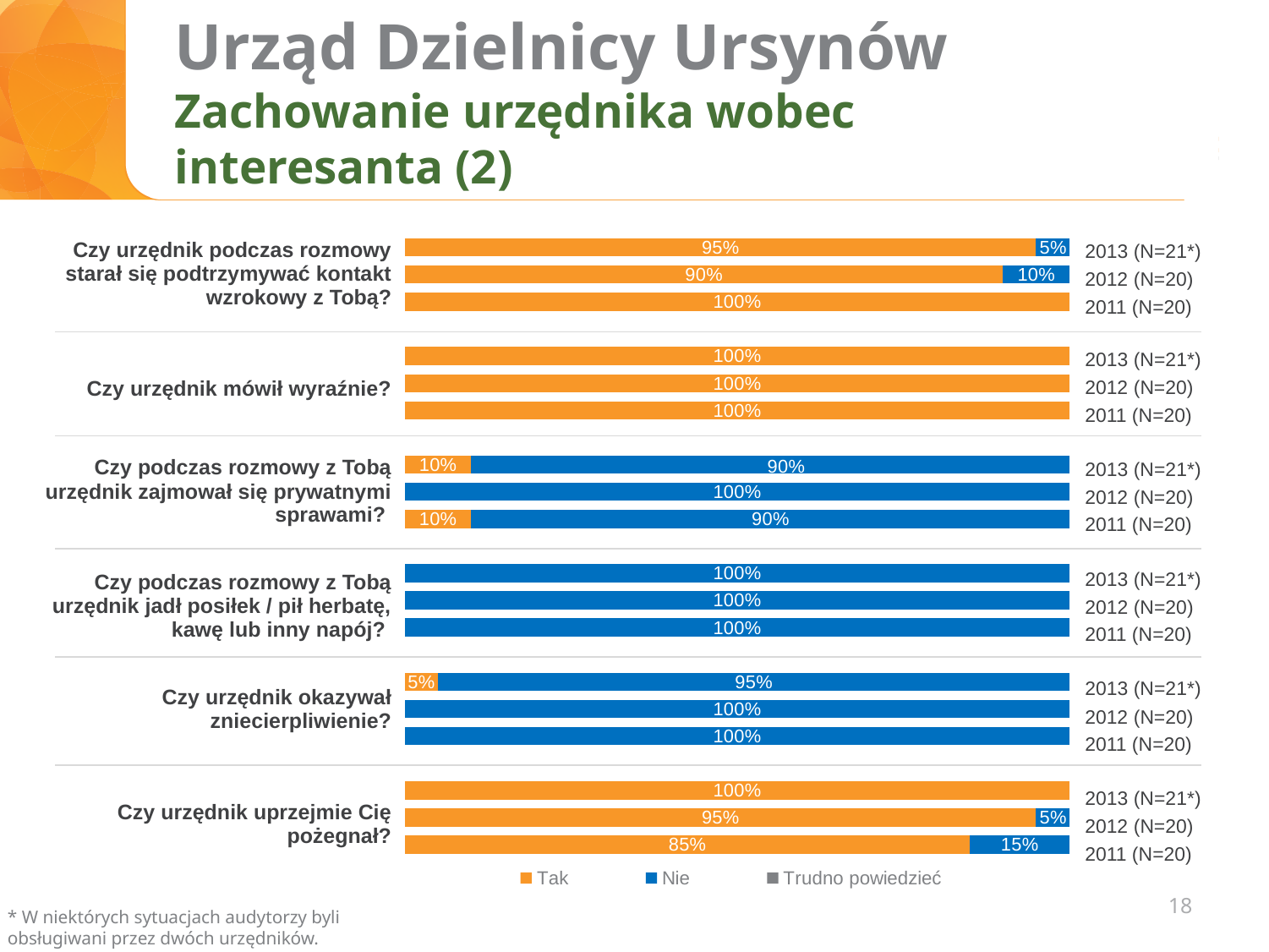
What is the 'Tak' value for 2013 (N=21*) for the question 'Czy podczas rozmowy z Tobą urzędnik zajmował się prywatnymi sprawami?' 10% What is the 'Nie' value for 2012 (N=20) for the question 'Czy urzędnik podczas rozmowy starał się podtrzymywać kontakt wzrokowy z Tobą?' 10% What is the 'Nie' value for 2013 (N=21*) for the question 'Czy urzędnik okazywał zniecierpliwienie?' 95% What is the 'Tak' value for 2011 (N=20) for the question 'Czy urzędnik uprzejmie Cię pożegnał?' 85% For the question 'Czy urzędnik uprzejmie Cię pożegnał?', what is the difference between the 'Tak' values for 2013 (N=21*) and 2011 (N=20)? 15% What are the legend entries of the chart? Tak, Nie, Trudno powiedzieć What kind of chart is shown on the slide? stacked bar chart What is the 'Nie' value for 2011 (N=20) for the question 'Czy urzędnik uprzejmie Cię pożegnał?' 15% For the question 'Czy urzędnik podczas rozmowy starał się podtrzymywać kontakt wzrokowy z Tobą?', which is larger: the 'Tak' value for 2013 (N=21*) or for 2012 (N=20)? 2013 (N=21*) For the question 'Czy urzędnik uprzejmie Cię pożegnał?', which year has the lowest 'Tak' value? 2011 (N=20) How many series does the legend list? 3 What is the 'Tak' value for 2013 (N=21*) for the question 'Czy urzędnik podczas rozmowy starał się podtrzymywać kontakt wzrokowy z Tobą?' 95%